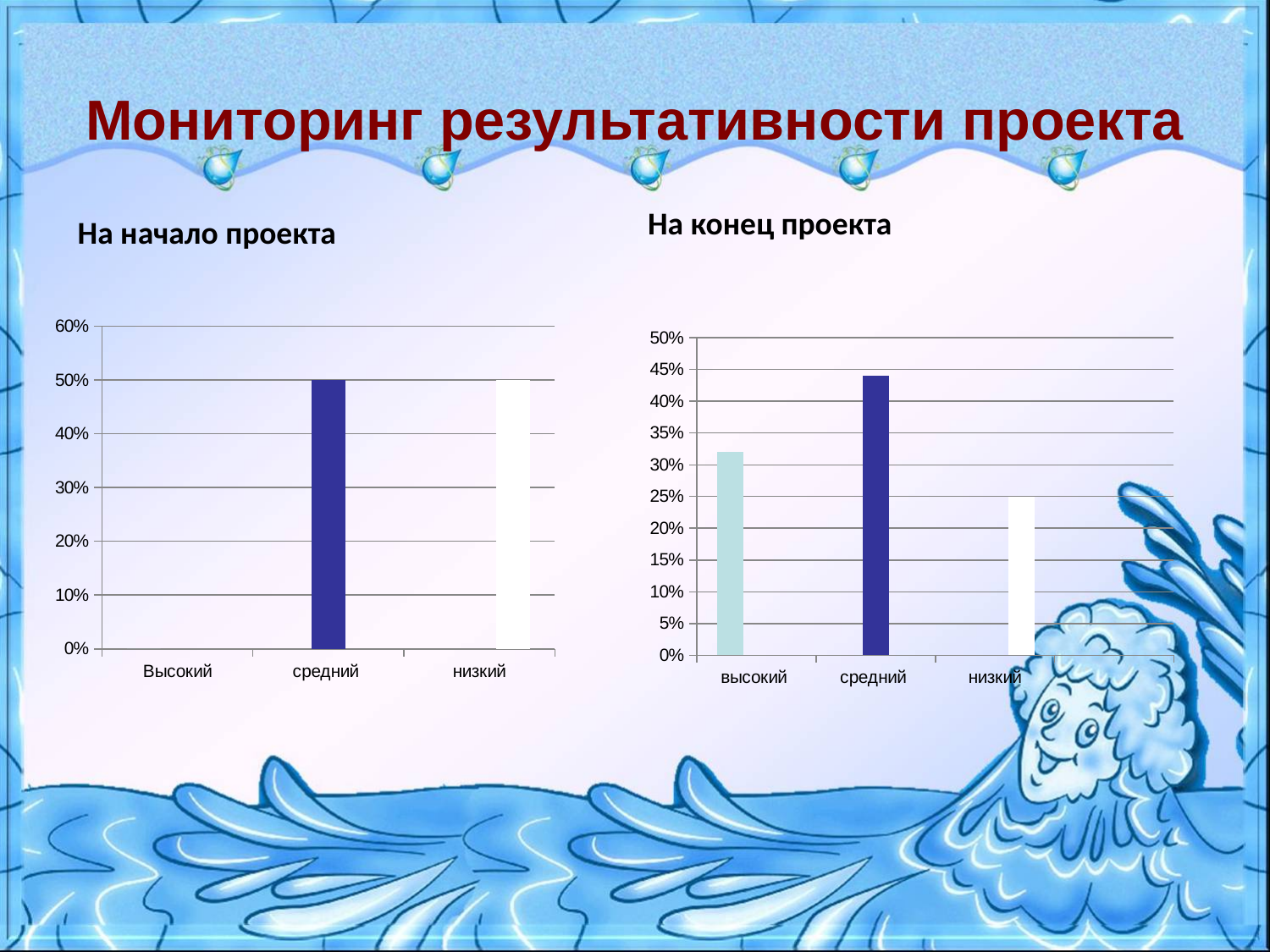
On the chart titled "На конец проекта", what is the value for низкий? 25% On the chart titled "На конец проекта", which category has the highest value? средний On the chart titled "На конец проекта", which category has the lowest value? низкий What is the title of the chart on the right side of the slide? На конец проекта On the chart titled "На конец проекта", is the value for средний greater or less than 40%? greater On the chart titled "На конец проекта", which is larger, the value for высокий or the value for низкий? высокий On the chart titled "На начало проекта", what is the value for средний? 50% On the chart titled "На конец проекта", is the value for высокий greater or less than 30%? greater On the chart titled "На начало проекта", what is the value for низкий? 50% On the chart titled "На начало проекта", how many categories are shown on the x axis? 3 On the chart titled "На начало проекта", which category has the lowest value? Высокий What kind of chart is the one titled "На начало проекта"? Bar chart